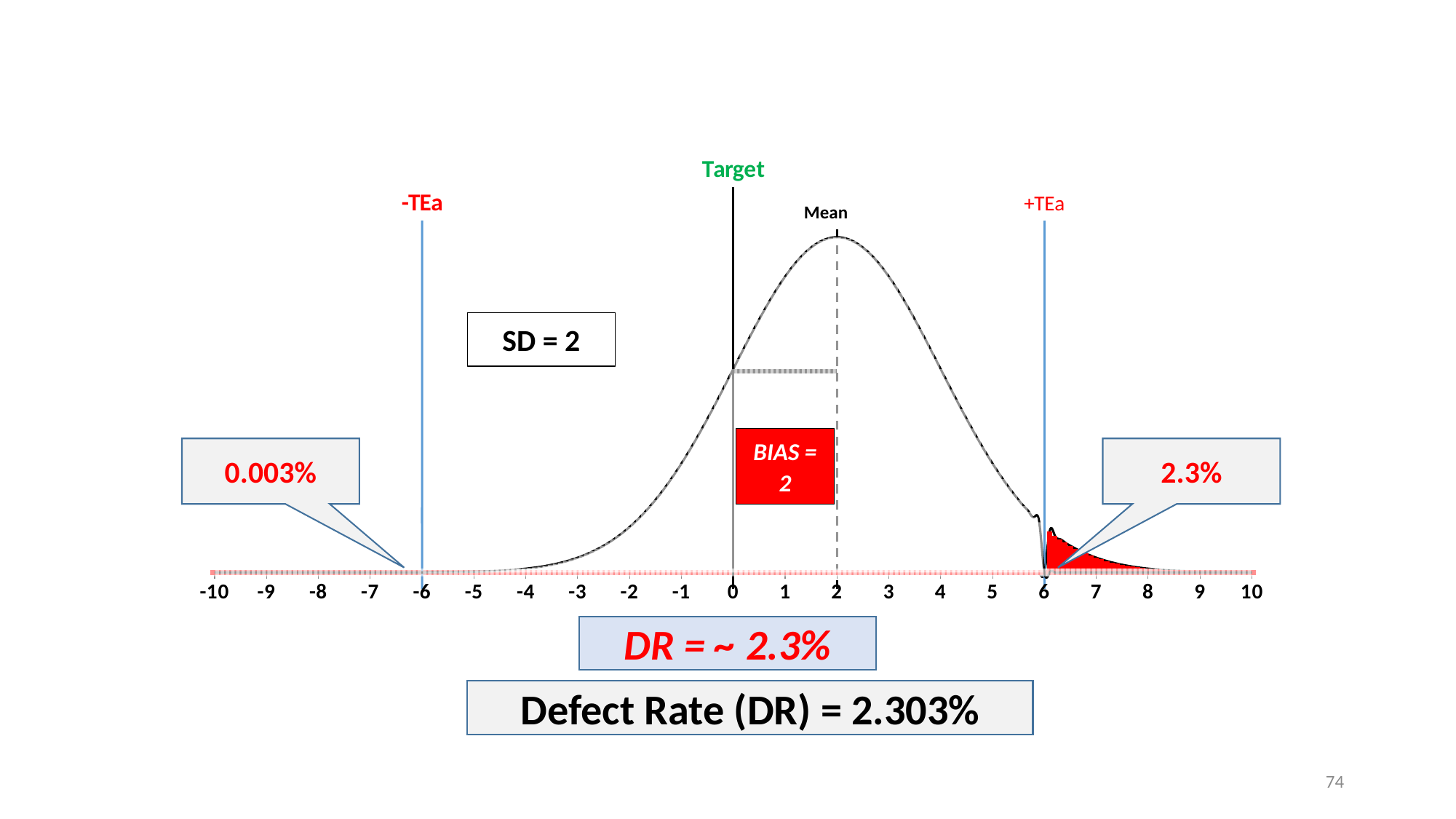
At what x-axis value is the Target line located? 0 What percentage is labelled in the callout at the right tail near +TEa? 2.3% What is the Defect Rate (DR) stated below the chart? 2.303% What is the difference between the right-tail percentage (2.3%) and the left-tail percentage (0.003%)? 2.297% What is the SD value shown on the chart? 2 Which tail has the larger labelled percentage, the left tail at -TEa or the right tail at +TEa? right tail at +TEa At what x-axis value is the -TEa line located? -6 What colour is the shaded area beyond the +TEa line? red What percentage is labelled in the callout at the left tail near -TEa? 0.003% What is the BIAS value shown in the red box on the chart? 2 At what x-axis value is the Mean line located? 2 At what x-axis value is the +TEa line located? 6